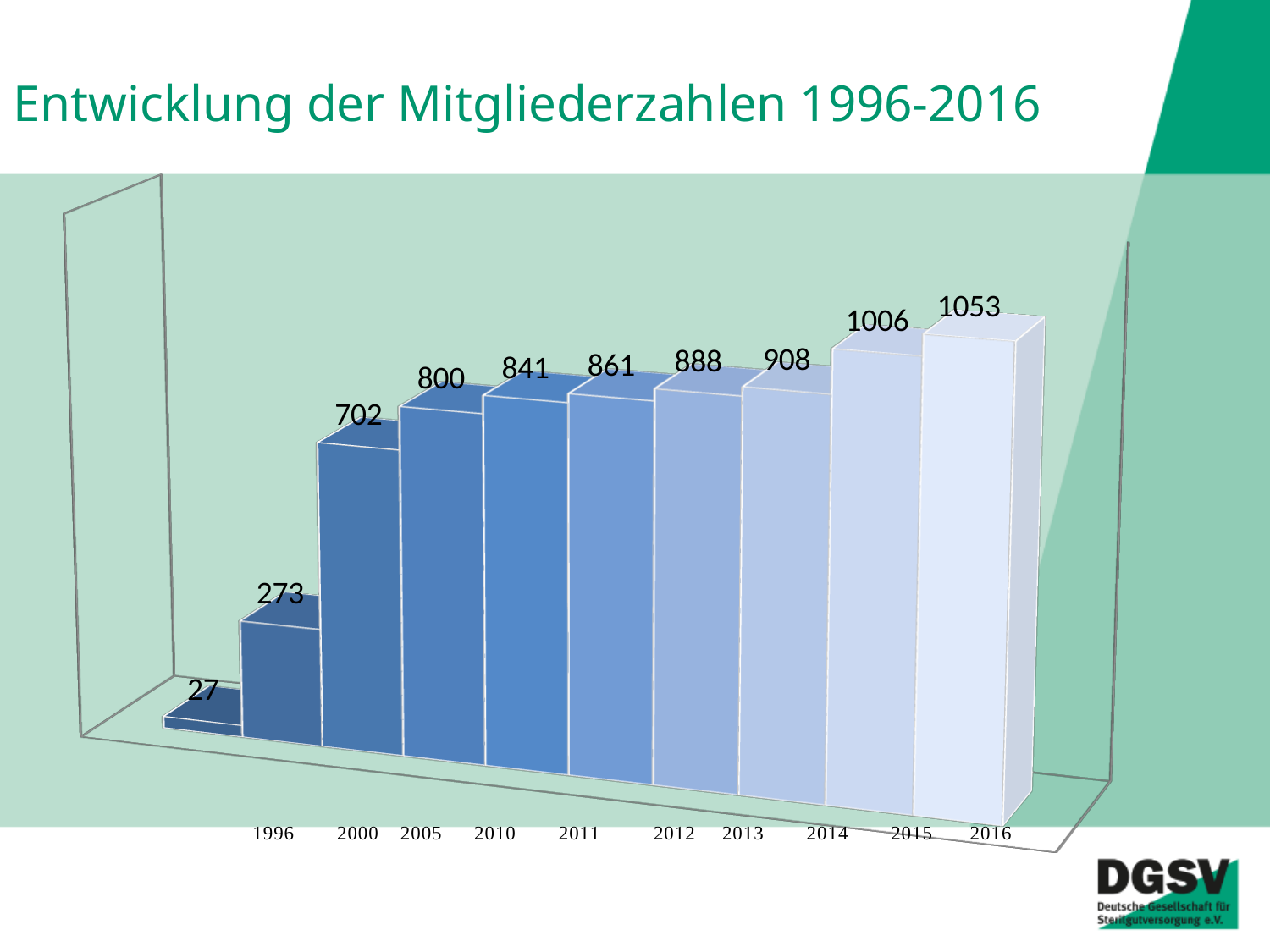
What is the value for 2014? 908 What is the value for 2005? 702 What is the difference between the values for 2000 and 1996? 246 What is the difference between the values for 2016 and 2015? 47 What is the value for 1996? 27 What is the title of the chart? Entwicklung der Mitgliederzahlen 1996-2016 How many years are shown on the x axis? 10 Which is larger, the value for 2010 or the value for 2012? 2012 Which year has the highest value? 2016 Which year has the lowest value? 1996 Do the values rise or fall from 1996 to 2016? rise What kind of chart is shown? bar chart